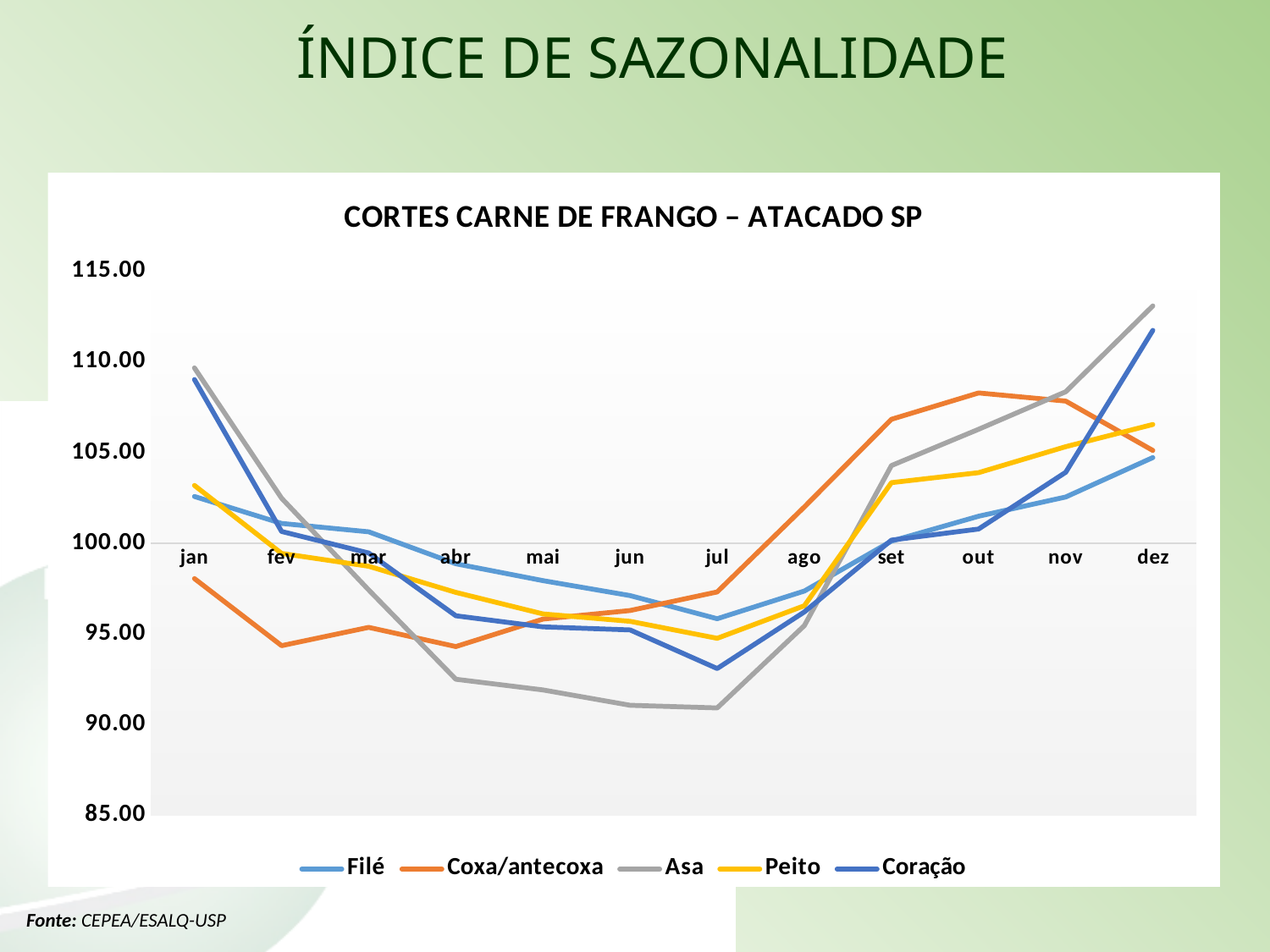
What is the title of the chart? CORTES CARNE DE FRANGO – ATACADO SP Which series has the lowest value in jan? Coxa/antecoxa Which series has the highest value in dez? Asa How many months are plotted along the x axis? 12 Does the Asa series rise or fall from jan to jul? fall What kind of chart is shown on the slide? line chart In jan, which is larger: the value for Asa or the value for Coxa/antecoxa? Asa Is the value for Coxa/antecoxa in out greater or less than 105.00? greater Is the value for Coração in dez greater or less than 110.00? greater Which series has the lowest value in jul? Asa How many series does the legend list? 5 Is the value for Asa in jul greater or less than 95.00? less